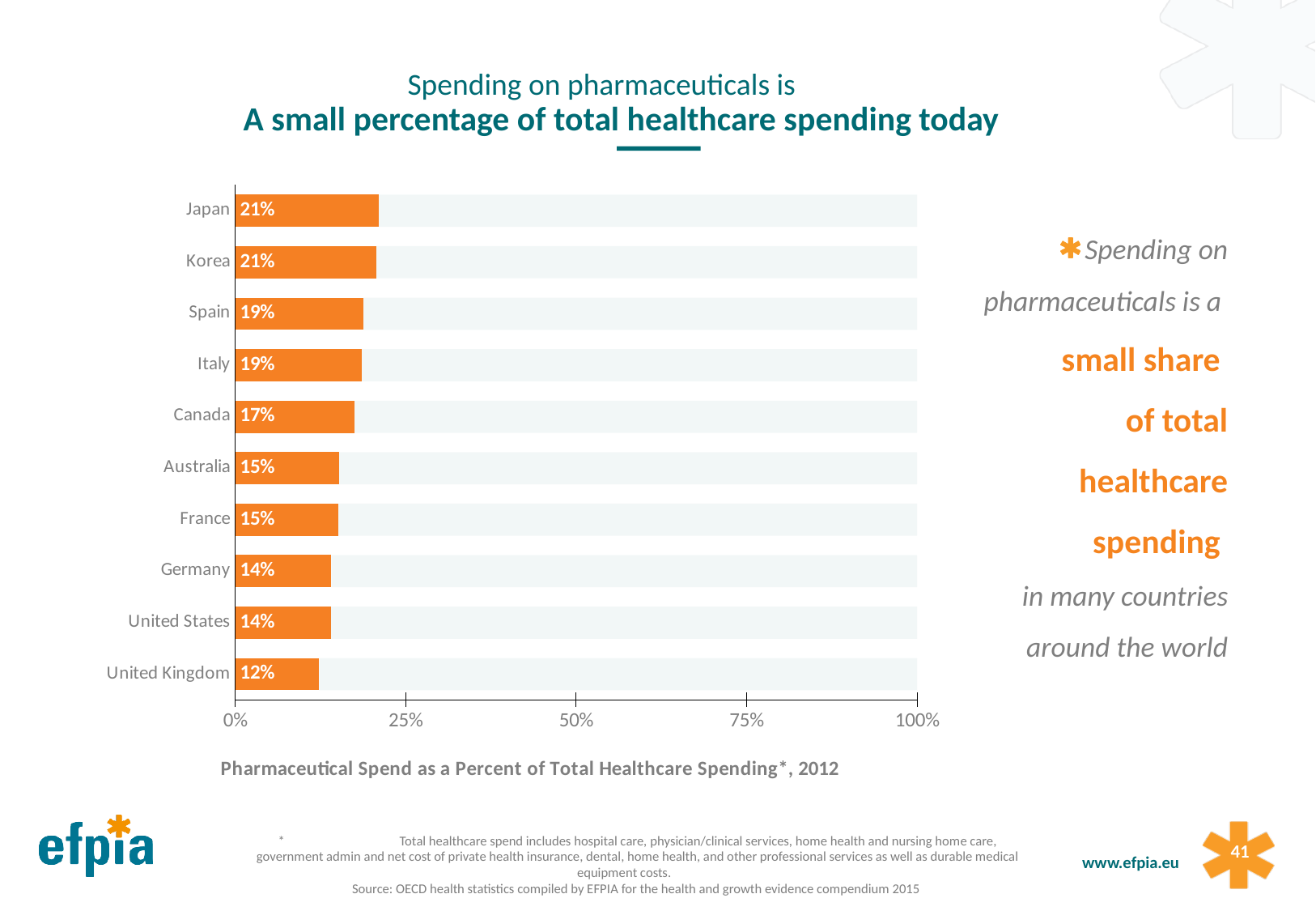
Which country has the lowest pharmaceutical spend as a percent of total healthcare spending? United Kingdom What is the value for Japan? 21% What is the value for Canada? 17% What is the difference between the values for Japan and the United Kingdom? 9% What kind of chart is shown on the slide? bar chart What is the value for the United Kingdom? 12% How many countries are shown in the chart? 10 Which is larger, the value for Canada or the value for Australia? Canada What is the caption below the chart? Pharmaceutical Spend as a Percent of Total Healthcare Spending*, 2012 What is the value for Germany? 14% What is the difference between the values for Spain and France? 4% Is the value for Korea greater or less than 25%? less